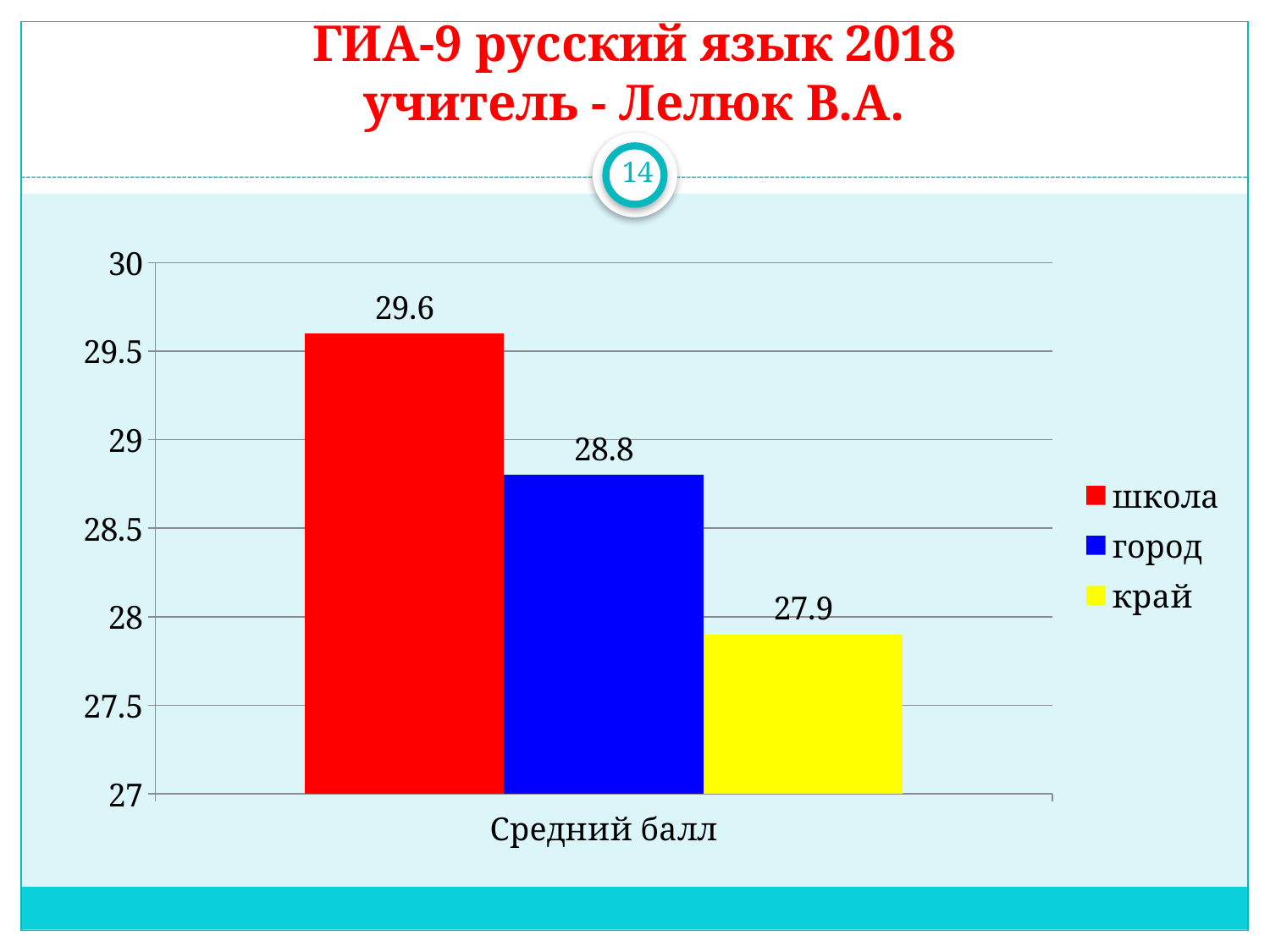
Which series has the lowest value? край What is the value for край (region) in the chart? 27.9 What kind of chart is shown on the slide? bar chart What is the label on the x axis of the chart? Средний балл What is the value for школа (school) in the chart? 29.6 What is the value for город (city) in the chart? 28.8 Which is larger, the value for город or the value for край? город How many series does the legend list? 3 Is the value for край greater or less than 28? less What is the difference between the values for школа and край? 1.7 What is the difference between the values for школа and город? 0.8 Which series has the highest value? школа